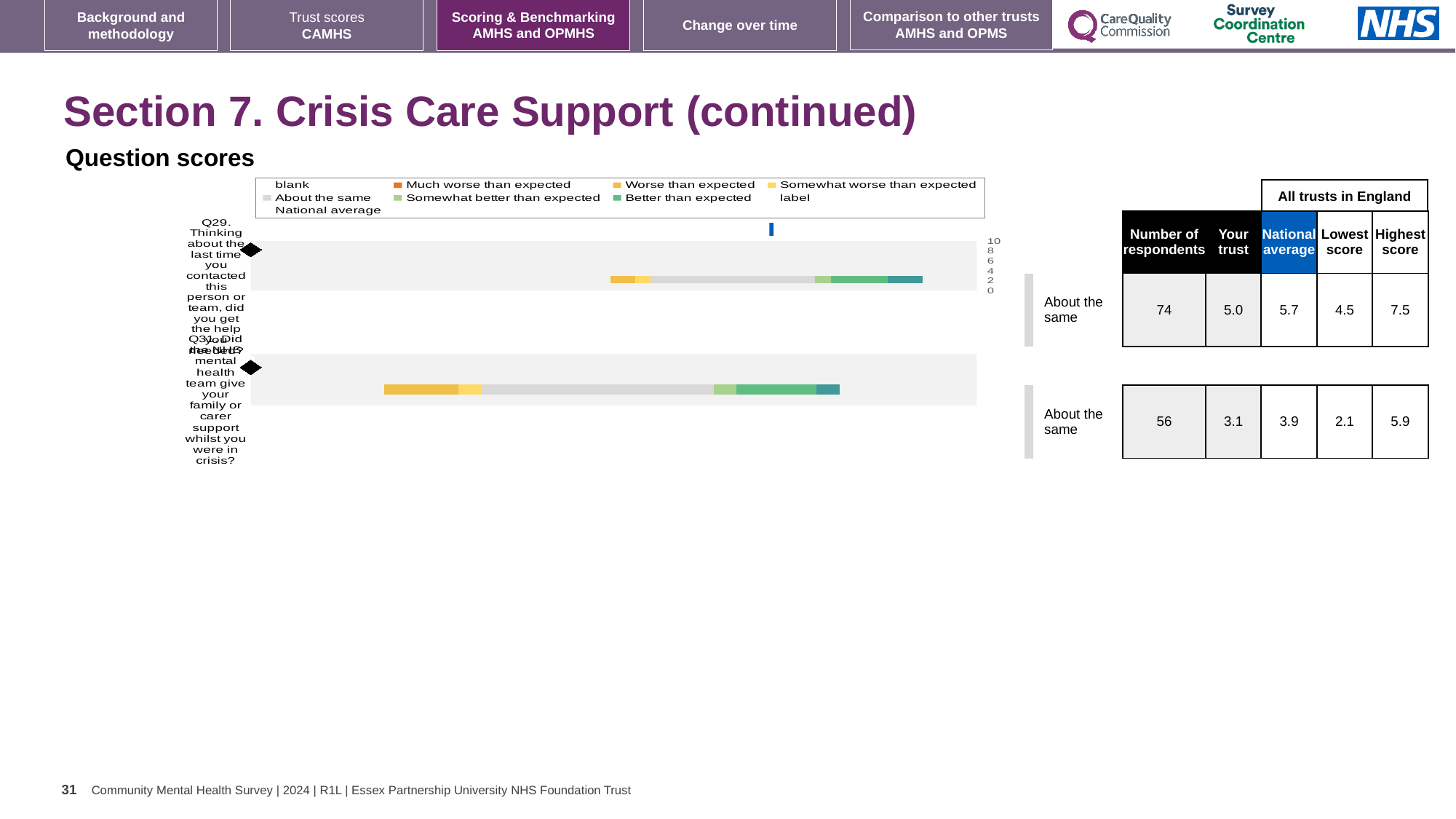
How many entries does the legend of the question scores chart list? 9 In the table beside the chart, what is the 'Your trust' score for Q31? 3.1 In the table beside the chart, what is the difference between the national average and the 'Your trust' score for Q31? 0.8 In the table beside the chart, what is the number of respondents for Q29? 74 What is the highest tick value shown on the score axis of the question scores chart? 10 How many questions (bars) are plotted in the question scores chart? 2 In the table beside the chart, which is larger for Q29: the 'Your trust' score or the national average? National average In the table beside the chart, what is the national average for Q29? 5.7 In the table beside the chart, what is the difference between the highest score and the lowest score for Q29? 3.0 What kind of chart is used to show the question scores for Q29 and Q31? bar chart In the table beside the chart, what is the highest score among all trusts in England for Q31? 5.9 Which legend entry in the question scores chart is shown in dark orange? Much worse than expected